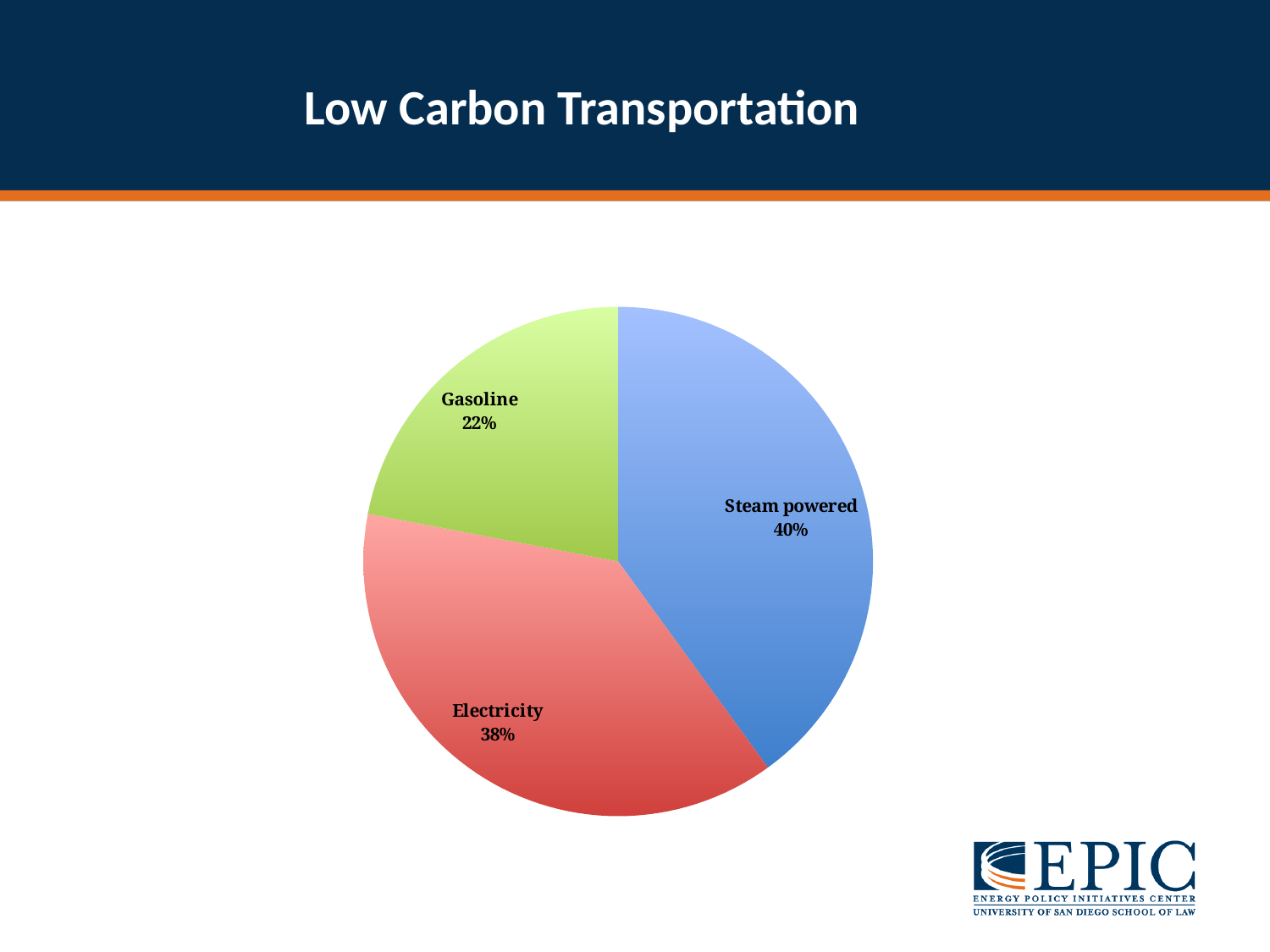
What share of the pie does Gasoline account for? 22% What is the difference in percentage points between the Electricity and Gasoline slices? 16 Which is larger, the Electricity slice or the Gasoline slice? Electricity What share of the pie does Steam powered account for? 40% Which slice of the pie is the smallest? Gasoline How many slices does the pie chart have? 3 What is the difference in percentage points between the Steam powered and Gasoline slices? 18 What colour is the Electricity slice? Red What share of the pie does Electricity account for? 38% Which slice of the pie is the largest? Steam powered What is the title of the slide containing the chart? Low Carbon Transportation What kind of chart is shown on the slide? Pie chart